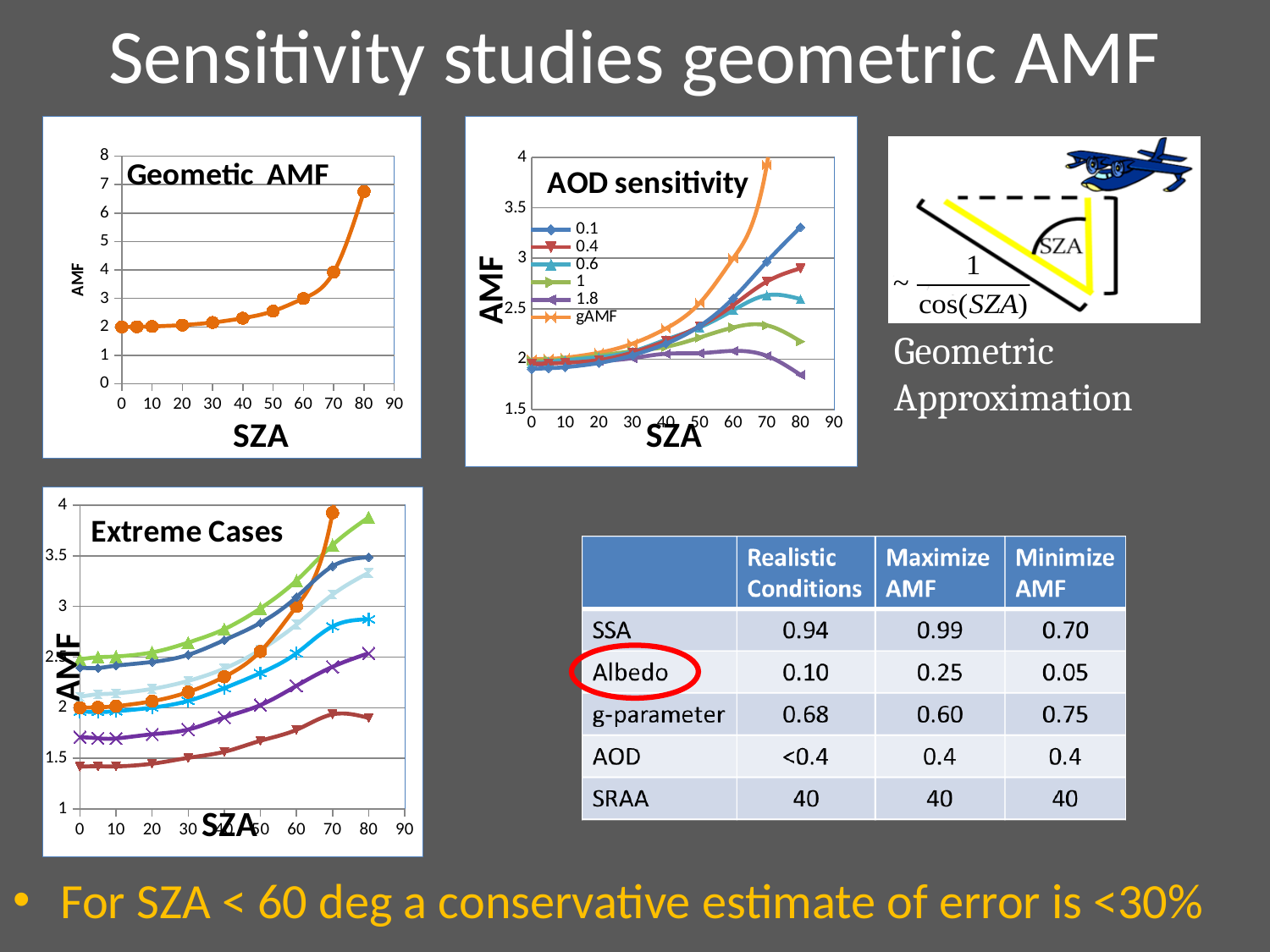
In the "Geometic AMF" chart, do the values rise or fall as SZA increases? rise What kind of chart is the "Geometic AMF" chart? line chart In the "AOD sensitivity" chart, which series has the lowest value at SZA 80? 1.8 What kind of chart is the "Extreme Cases" chart? line chart How many series does the legend of the "AOD sensitivity" chart list? 6 What is the x-axis title of the "Geometic AMF" chart? SZA In the "AOD sensitivity" chart, which series reaches the highest AMF value? gAMF In the "Geometic AMF" chart, is the value at SZA 0 greater or less than 3? less In the "Geometic AMF" chart, is the value at SZA 80 greater or less than 6? greater What are the legend entries in the "AOD sensitivity" chart? 0.1, 0.4, 0.6, 1, 1.8, gAMF In the "AOD sensitivity" chart, is the gAMF value at SZA 70 greater or less than 3.5? greater In the "AOD sensitivity" chart, at SZA 80, which series has the larger value, 0.1 or 0.4? 0.1